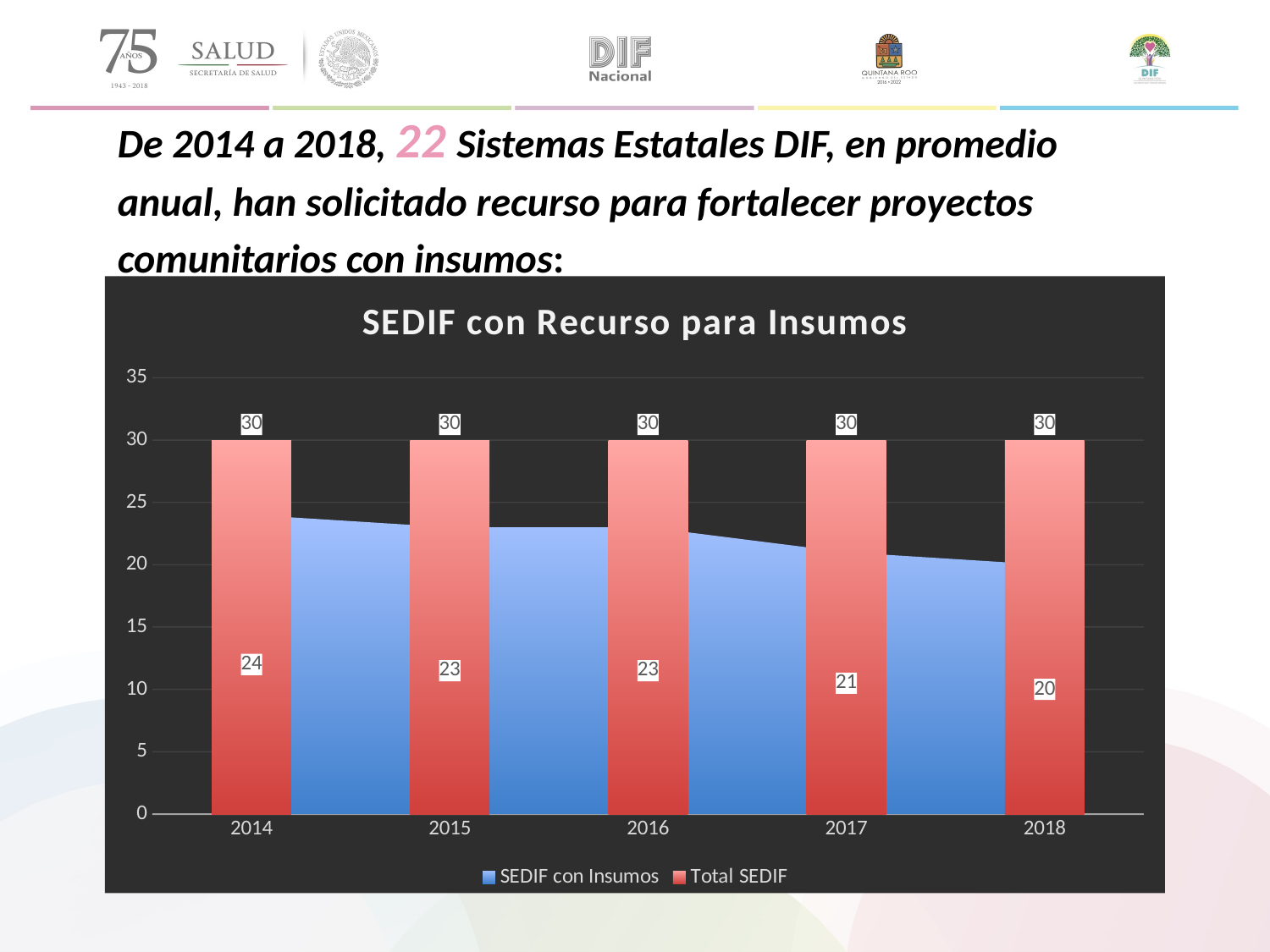
Does SEDIF con Insumos rise or fall from 2014 to 2018? fall What is the difference between SEDIF con Insumos in 2014 and in 2017? 3 What is the value of SEDIF con Insumos for 2014? 24 In which year is SEDIF con Insumos lowest? 2018 What is the value of SEDIF con Insumos for 2017? 21 What is the value of Total SEDIF for 2016? 30 How many series does the legend list? 2 In which year is SEDIF con Insumos highest? 2014 Which is larger in 2015: SEDIF con Insumos or Total SEDIF? Total SEDIF What is the value of SEDIF con Insumos for 2018? 20 How many years are shown on the x axis? 5 What is the difference between Total SEDIF and SEDIF con Insumos in 2018? 10